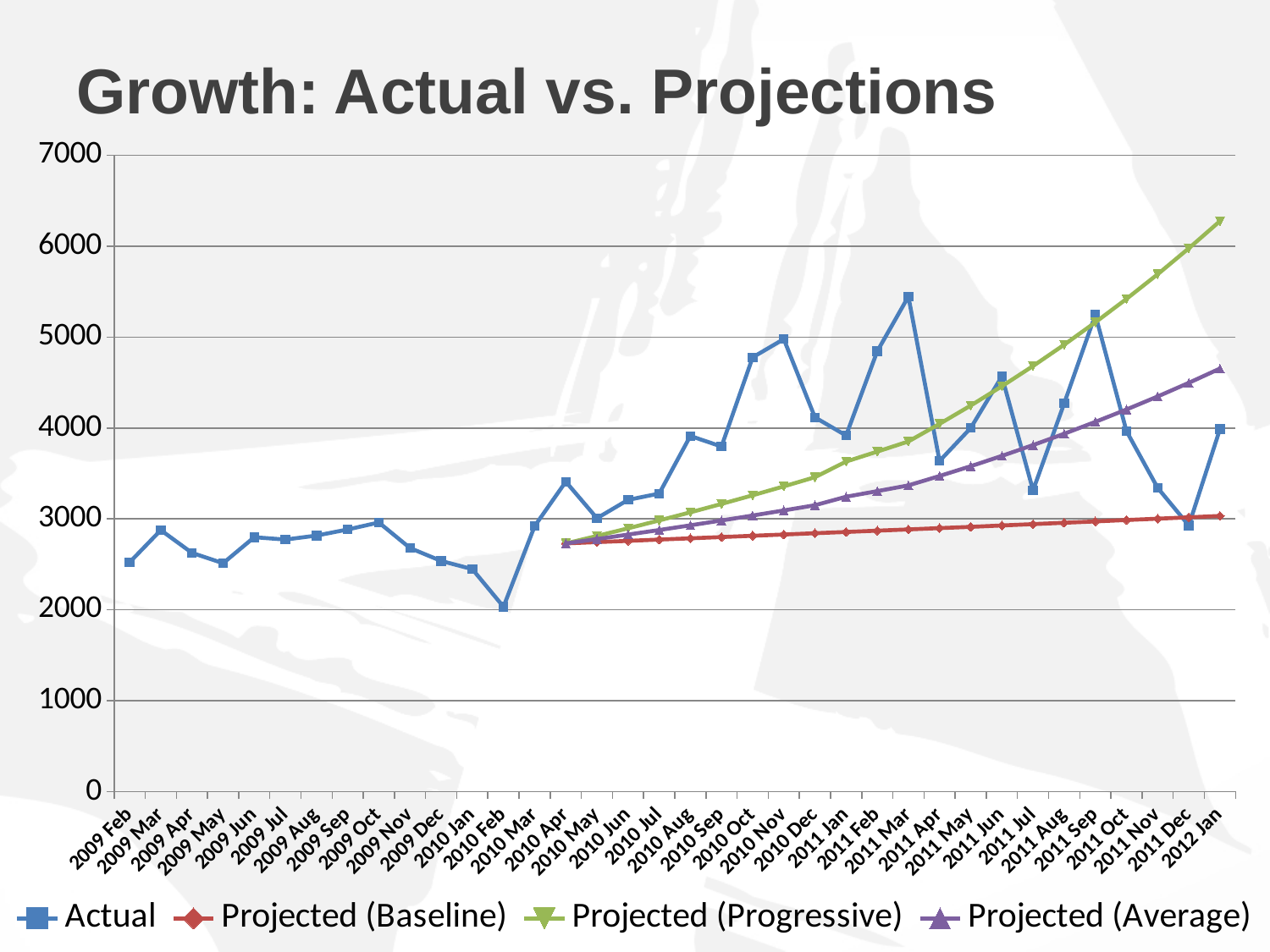
Is the Projected (Average) value for 2012 Jan greater or less than 4000? greater Does the Projected (Progressive) series rise or fall along the x axis? Rise At 2012 Jan, which is higher: the Actual value or the Projected (Progressive) value? Projected (Progressive) In which month does the Actual series reach its highest value? 2011 Mar How many series does the legend list? 4 In which month does the Actual series reach its lowest value? 2010 Feb Is the Actual value for 2010 Feb greater or less than 3000? less What kind of chart is shown on the slide? Line chart What is the title of the chart? Growth: Actual vs. Projections How many months are plotted along the x axis? 36 Is the Projected (Progressive) value for 2012 Jan greater or less than 6000? greater